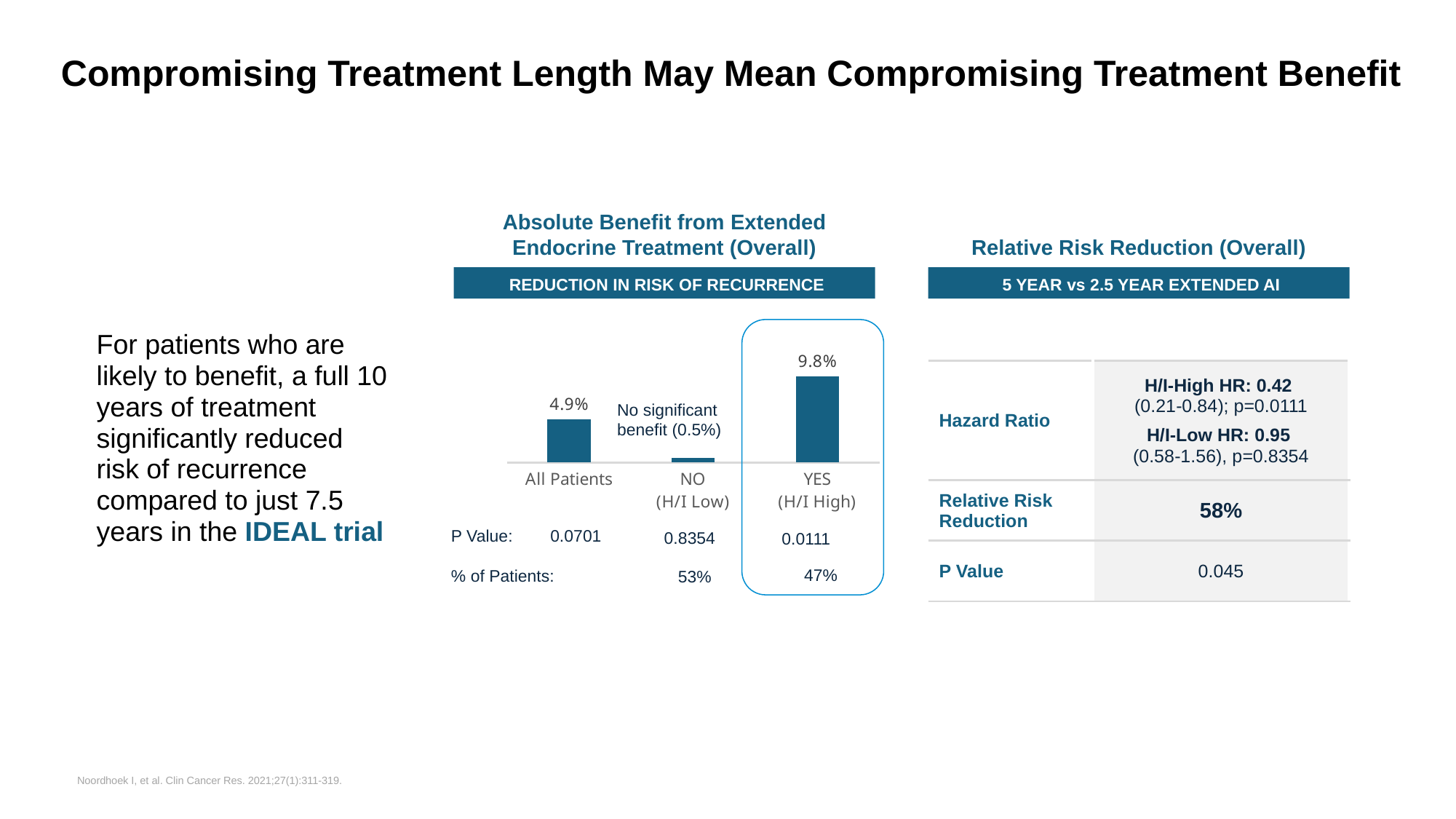
What kind of chart is the Absolute Benefit from Extended Endocrine Treatment chart? Bar chart What is the P value shown below the YES (H/I High) bar in the Absolute Benefit from Extended Endocrine Treatment chart? 0.0111 What is the value for YES (H/I High) in the Absolute Benefit from Extended Endocrine Treatment chart? 9.8% What is the value for NO (H/I Low) in the Absolute Benefit from Extended Endocrine Treatment chart? 0.5% Which category has the lowest value in the Absolute Benefit from Extended Endocrine Treatment chart? NO (H/I Low) How many categories are shown in the Absolute Benefit from Extended Endocrine Treatment chart? 3 In the Absolute Benefit from Extended Endocrine Treatment chart, which is larger: the value for All Patients or the value for YES (H/I High)? YES (H/I High) What is the difference between the YES (H/I High) and All Patients values in the Absolute Benefit from Extended Endocrine Treatment chart? 4.9% What is the banner text shown directly under the title of the Absolute Benefit from Extended Endocrine Treatment chart? REDUCTION IN RISK OF RECURRENCE Which category has the highest value in the Absolute Benefit from Extended Endocrine Treatment chart? YES (H/I High) What is the difference between the All Patients and NO (H/I Low) values in the Absolute Benefit from Extended Endocrine Treatment chart? 4.4% What is the value for All Patients in the Absolute Benefit from Extended Endocrine Treatment chart? 4.9%